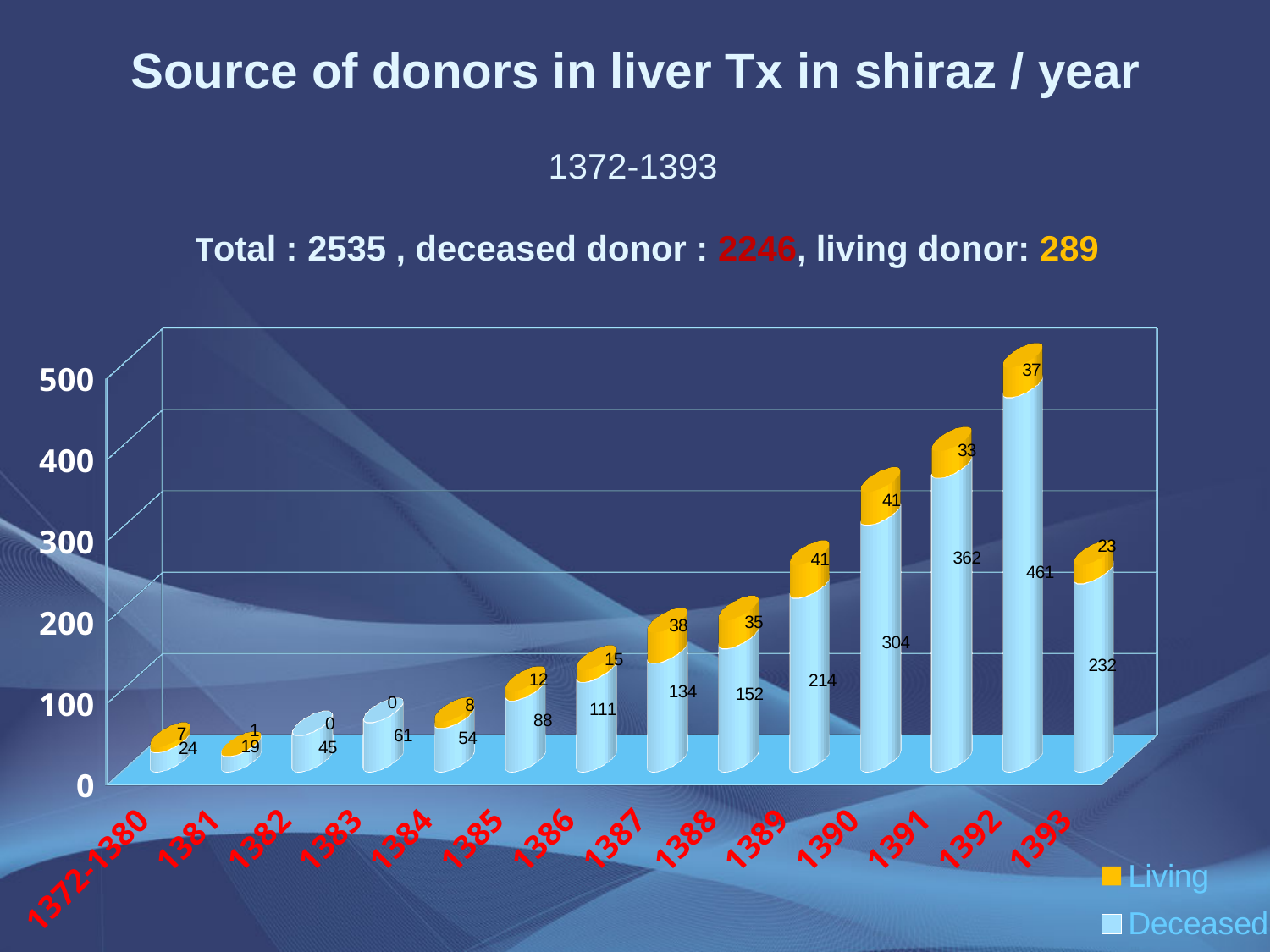
What is the total of the stacked bar for 1391 (Living plus Deceased)? 395 Which is larger, the Deceased donor value for 1388 or for 1389? 1389 What is the Deceased donor value for 1390? 304 What is the difference between the Deceased donor values for 1392 and 1393? 229 What kind of chart is shown on the slide? Stacked bar chart What is the Living donor value for 1387? 38 Which category has the lowest Deceased donor value? 1381 How many categories are shown on the x axis? 14 Which year has the highest Deceased donor value? 1392 What is the Deceased donor value for 1392? 461 Which series is shown in yellow in the legend? Living How many series does the legend list? 2